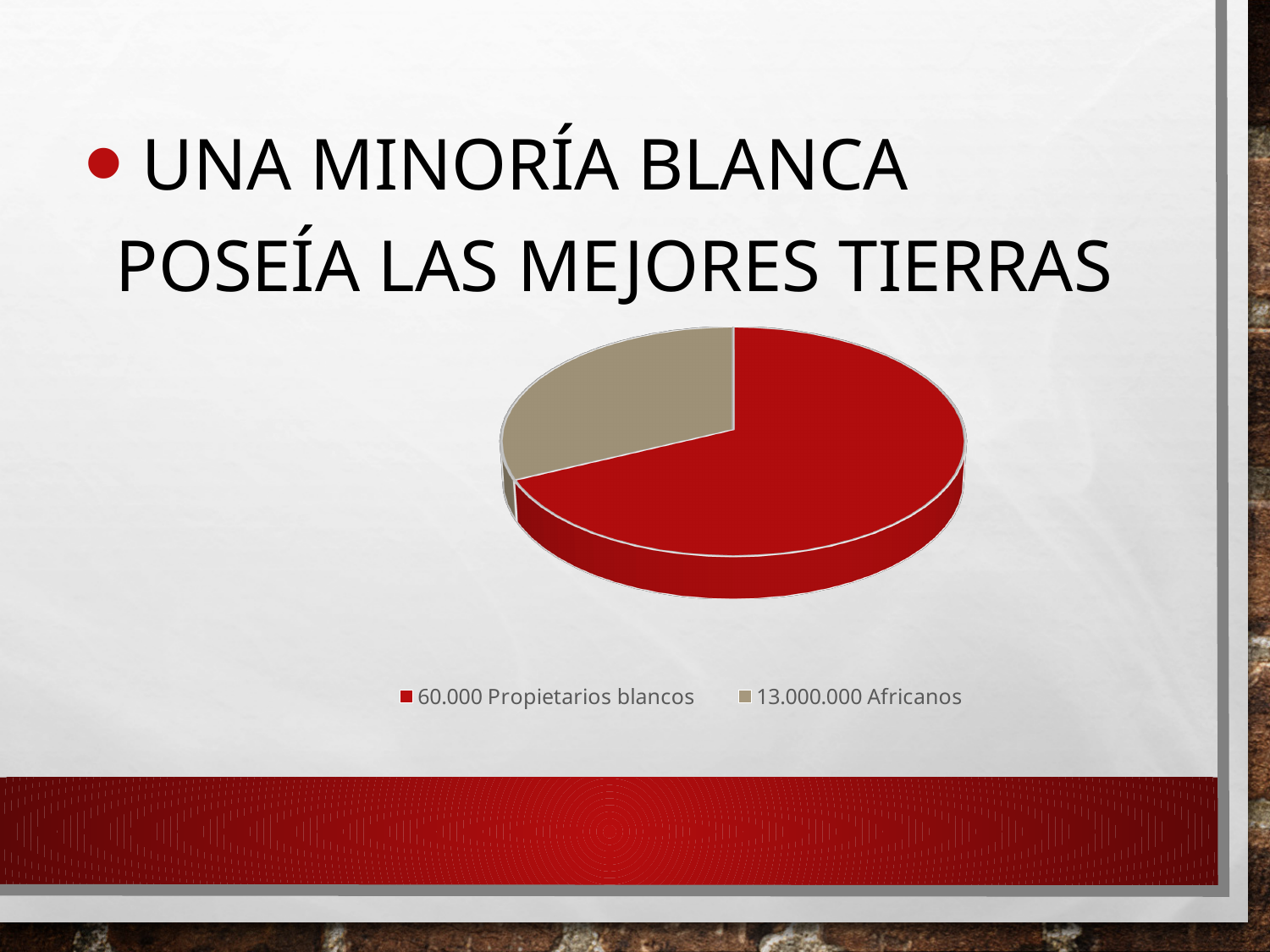
What colour is the "13.000.000 Africanos" slice in the pie chart? tan Which slice of the pie chart is the smallest? 13.000.000 Africanos Does the "60.000 Propietarios blancos" slice take up more or less than half of the pie chart? more What colour is the "60.000 Propietarios blancos" slice in the pie chart? red What kind of chart is shown on the slide? pie chart Which slice of the pie chart is the largest? 60.000 Propietarios blancos How many entries does the legend of the pie chart list? 2 How many slices does the pie chart have? 2 Which slice is larger in the pie chart: "60.000 Propietarios blancos" or "13.000.000 Africanos"? 60.000 Propietarios blancos